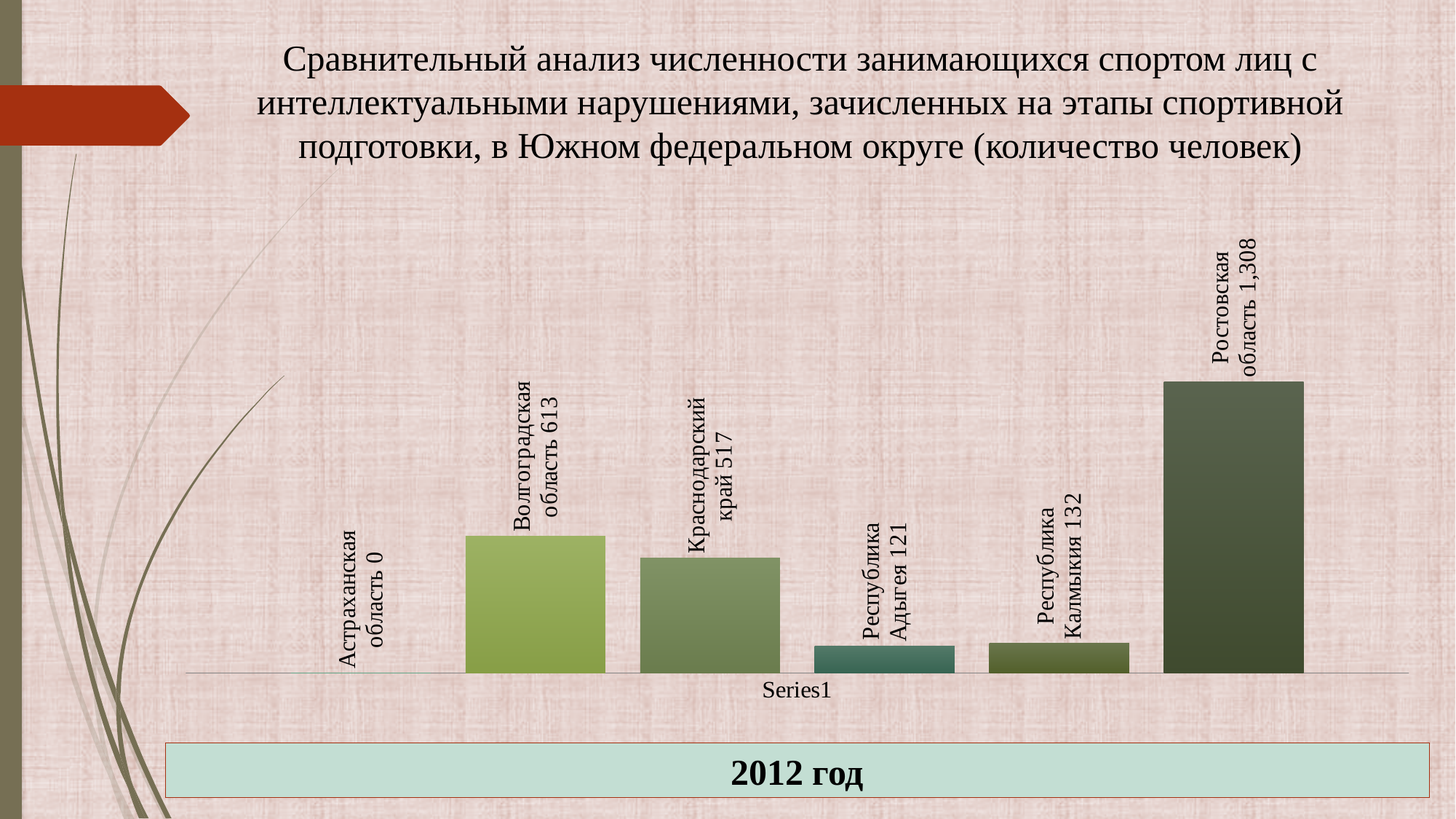
What year is shown in the box below the chart? 2012 год What kind of chart is shown on the slide? bar chart How many regions are shown in the chart? 6 What is the value for Республика Адыгея? 121 Which is larger, the value for Республика Калмыкия or the value for Республика Адыгея? Республика Калмыкия What is the difference between the values for Ростовская область and Волгоградская область? 695 What is the value for Ростовская область? 1,308 What is the value for Астраханская область? 0 Which region has the lowest value? Астраханская область What is the difference between the values for Волгоградская область and Краснодарский край? 96 Which region has the highest value? Ростовская область What is the value for Волгоградская область? 613